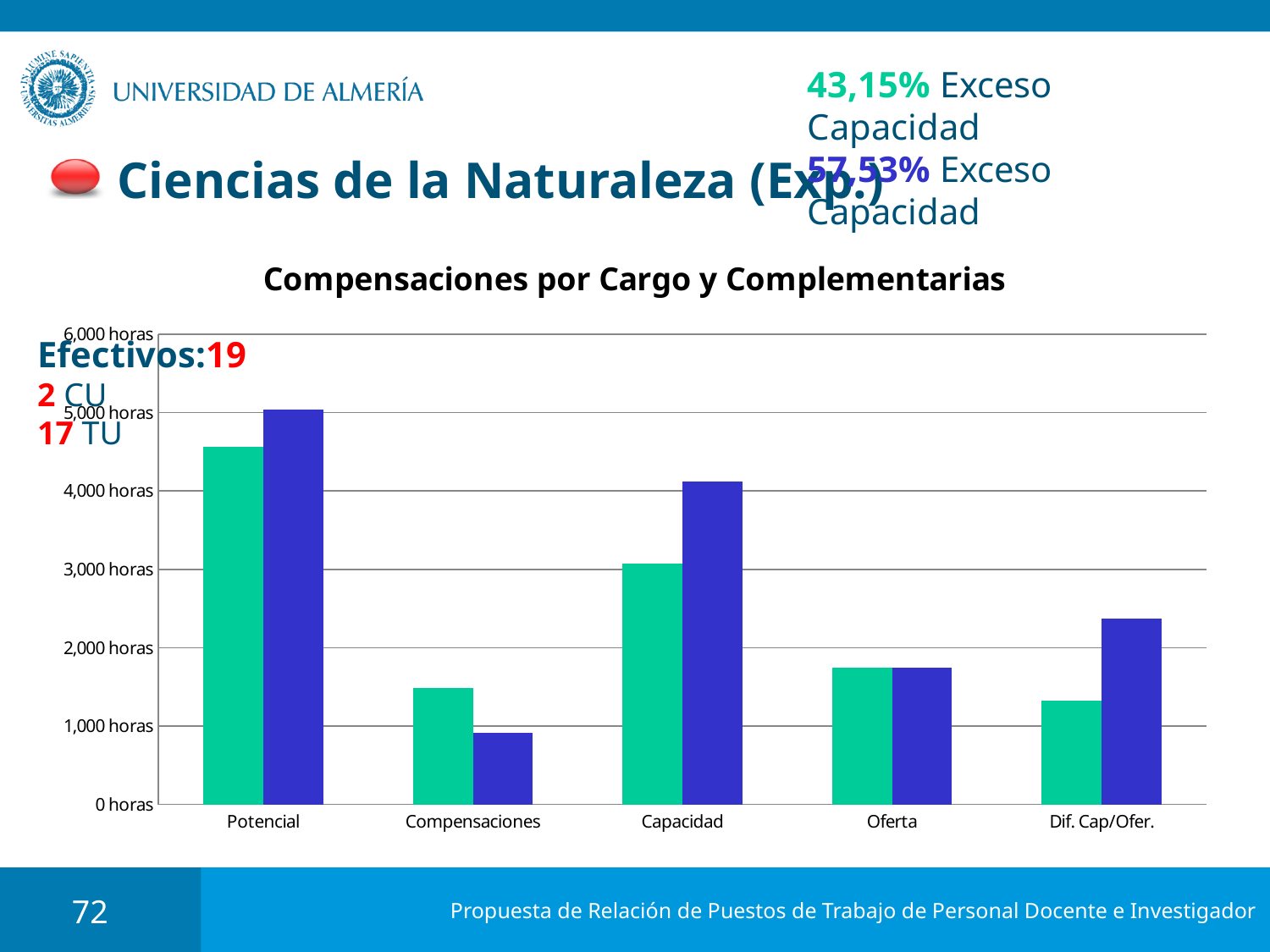
How many categories are shown on the x axis of the chart? 5 Which category has the tallest green bar? Potencial For Dif. Cap/Ofer., which bar is taller, the green one or the blue one? blue For Compensaciones, which bar is taller, the green one or the blue one? green Which category has the shortest blue bar? Compensaciones What is the title of the chart? Compensaciones por Cargo y Complementarias Is the blue bar for Dif. Cap/Ofer. greater or less than 2,000 horas? greater Is the green bar for Potencial greater or less than 4,000 horas? greater Is the blue bar for Compensaciones greater or less than 1,000 horas? less Which category has the tallest blue bar? Potencial For Potencial, which bar is taller, the green one or the blue one? blue What kind of chart is shown on the slide? bar chart